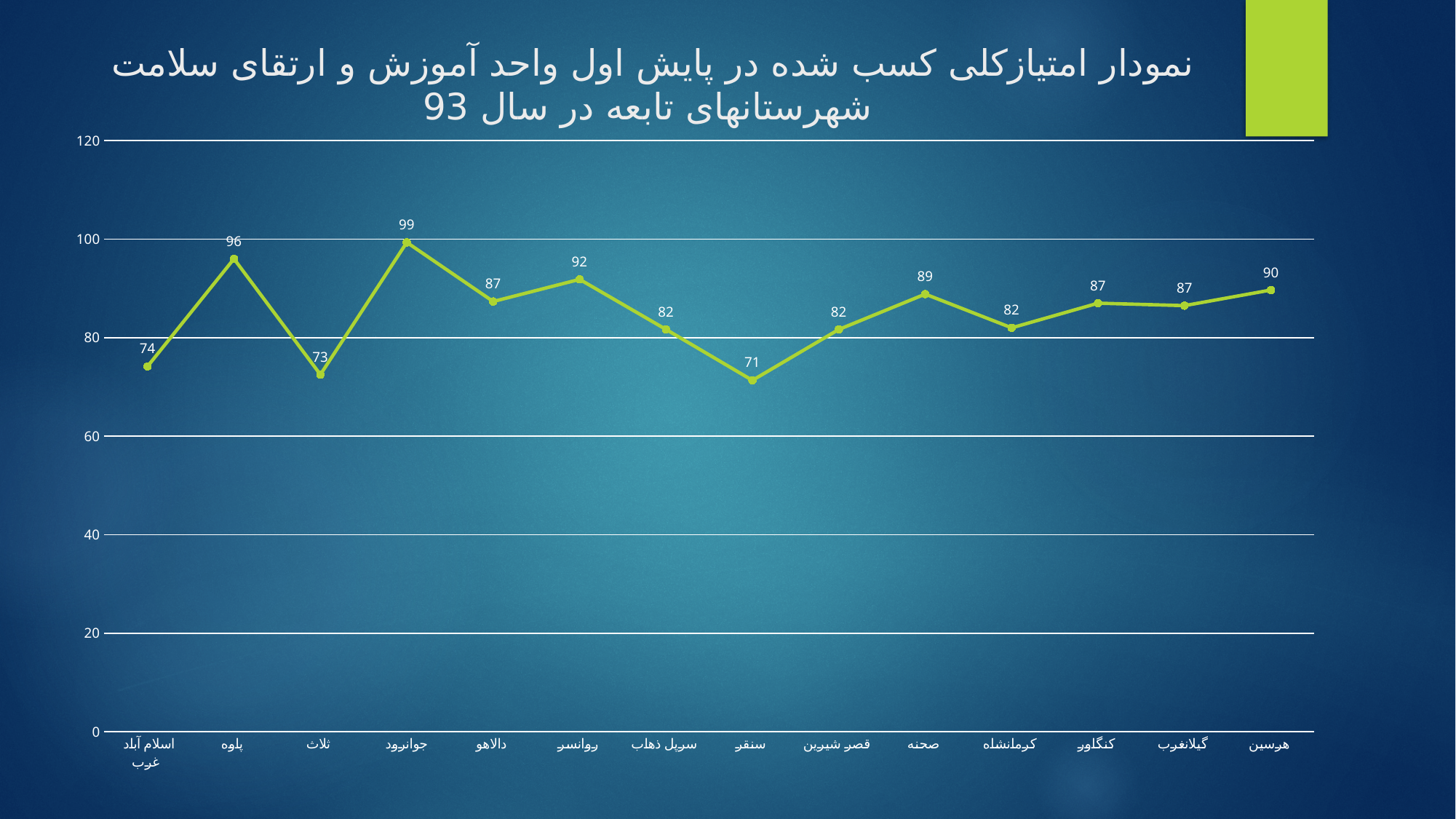
What is the value for جوانرود? 99 What type of chart is shown on the slide? line chart Is the value for روانسر greater or less than 80? greater What is the value for اسلام آباد غرب? 74 What is the value for سنقر? 71 What is the highest value shown on the y axis? 120 Which category has the highest value? جوانرود How many categories are plotted on the x axis? 14 What is the value for هرسین? 90 What is the difference between the values for پاوه and ثلاث? 23 Which is larger, the value for صحنه or the value for کرمانشاه? صحنه Which category has the lowest value? سنقر